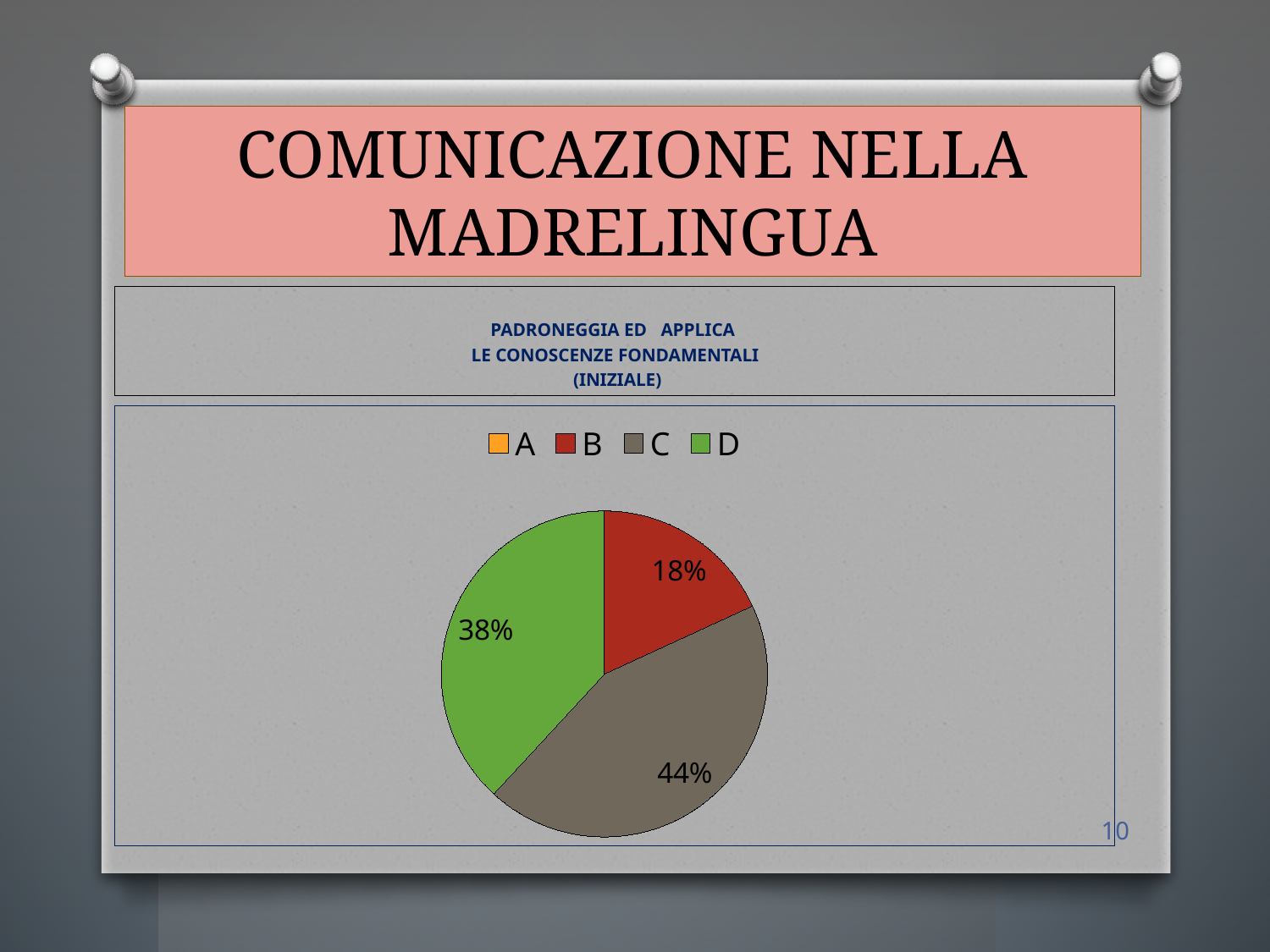
What percentage does slice B represent in the pie chart? 18% What is the difference in percentage points between slice C and slice D? 6 Which is larger in the pie chart, slice C or slice D? C How many entries does the legend of the pie chart list? 4 What percentage does slice D represent in the pie chart? 38% What colour is the slice for category C in the pie chart? grey What percentage does slice C represent in the pie chart? 44% What colour is the slice for category D in the pie chart? green What is the difference in percentage points between slice D and slice B? 20 Which is larger in the pie chart, slice B or slice D? D Which category has the largest slice in the pie chart? C What kind of chart is shown on the slide? pie chart